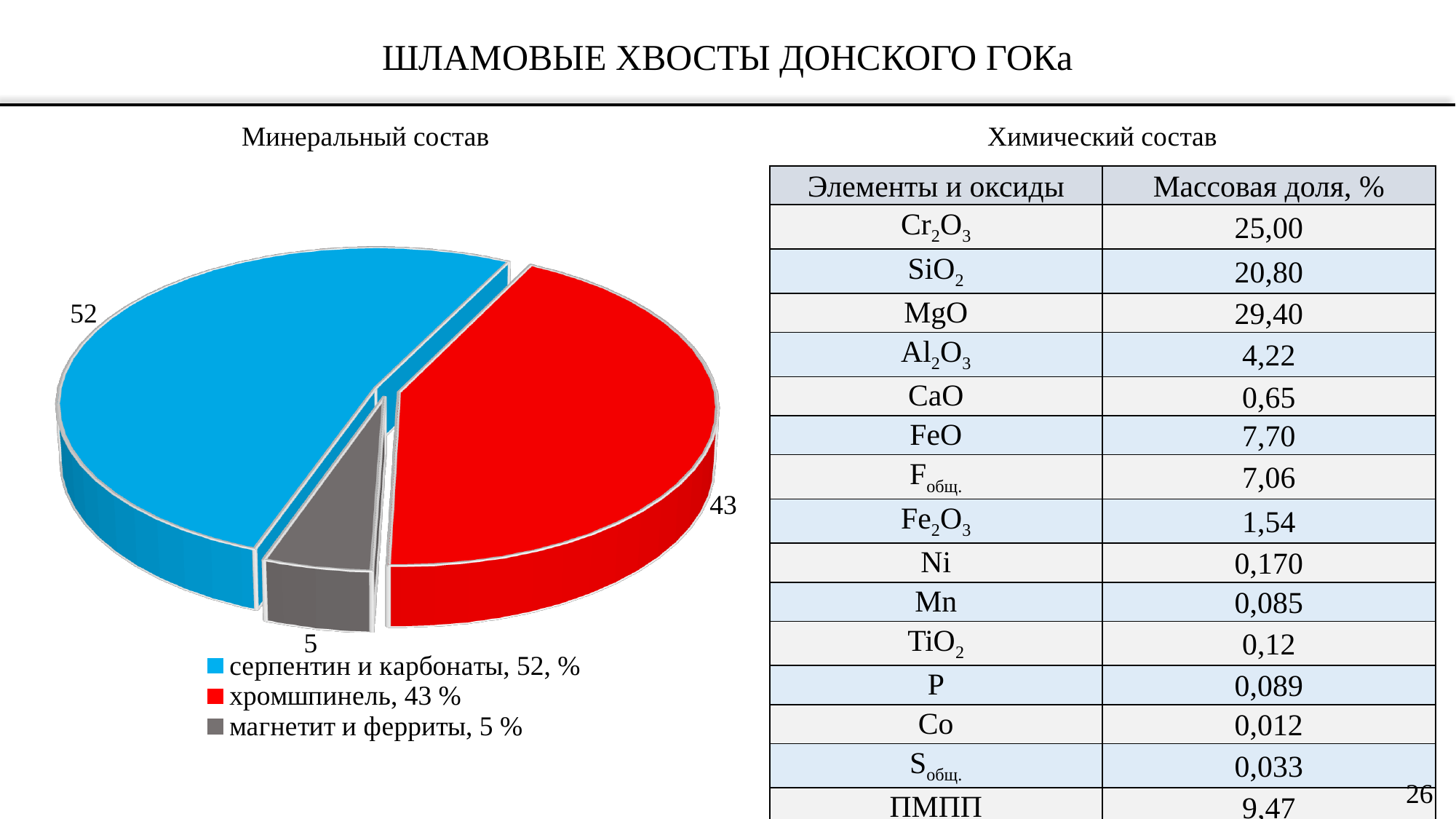
What is the value shown for "магнетит и ферриты" in the pie chart? 5 Which category has the largest slice in the pie chart? серпентин и карбонаты What is the value shown for "хромшпинель" in the pie chart? 43 How many slices does the pie chart have? 3 What is the value shown for "серпентин и карбонаты" in the pie chart? 52 What share of the pie does "хромшпинель" represent? 43 % What type of chart is shown under the heading "Минеральный состав"? pie chart Which is larger in the pie chart: "хромшпинель" or "магнетит и ферриты"? хромшпинель What is the difference between the values for "серпентин и карбонаты" and "хромшпинель" in the pie chart? 9 What is the title of the pie chart on the slide? Минеральный состав Which category has the smallest slice in the pie chart? магнетит и ферриты What colour is the slice for "магнетит и ферриты" in the pie chart? grey